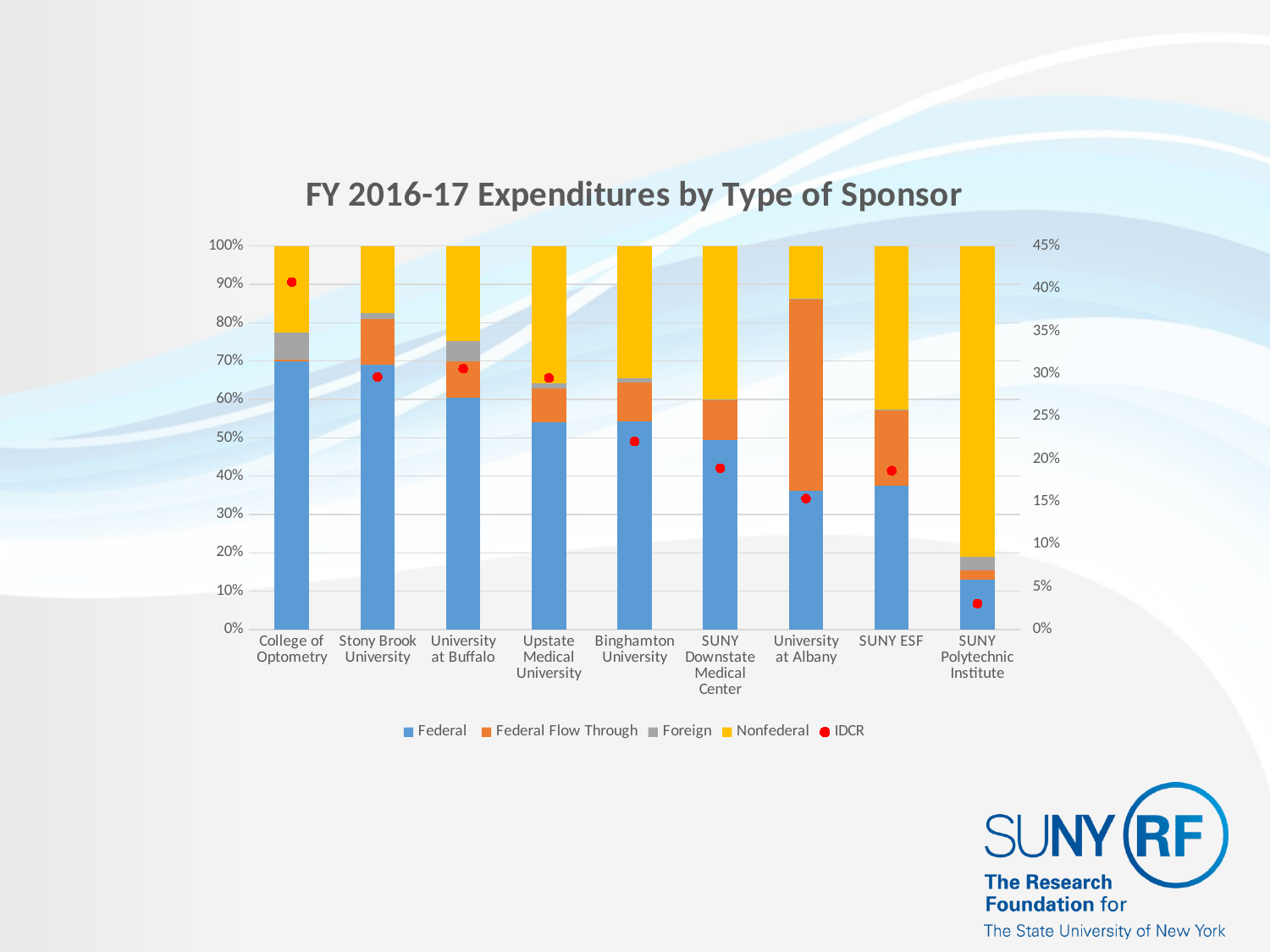
How many series does the legend list? 5 How many campuses (categories) are shown on the x axis? 9 Which has the larger Federal share, University at Buffalo or University at Albany? University at Buffalo What is the title of the chart? FY 2016-17 Expenditures by Type of Sponsor Which campus has the highest IDCR value? College of Optometry Is the Federal share for SUNY Polytechnic Institute greater or less than 20%? less Which campus has the largest Nonfederal share of expenditures? SUNY Polytechnic Institute Which campus has the lowest IDCR value? SUNY Polytechnic Institute Which series is plotted as red dots? IDCR What kind of chart is shown on the slide? Stacked bar chart Which campus has the largest Federal Flow Through share? University at Albany Which campus has the smallest Federal share of expenditures? SUNY Polytechnic Institute